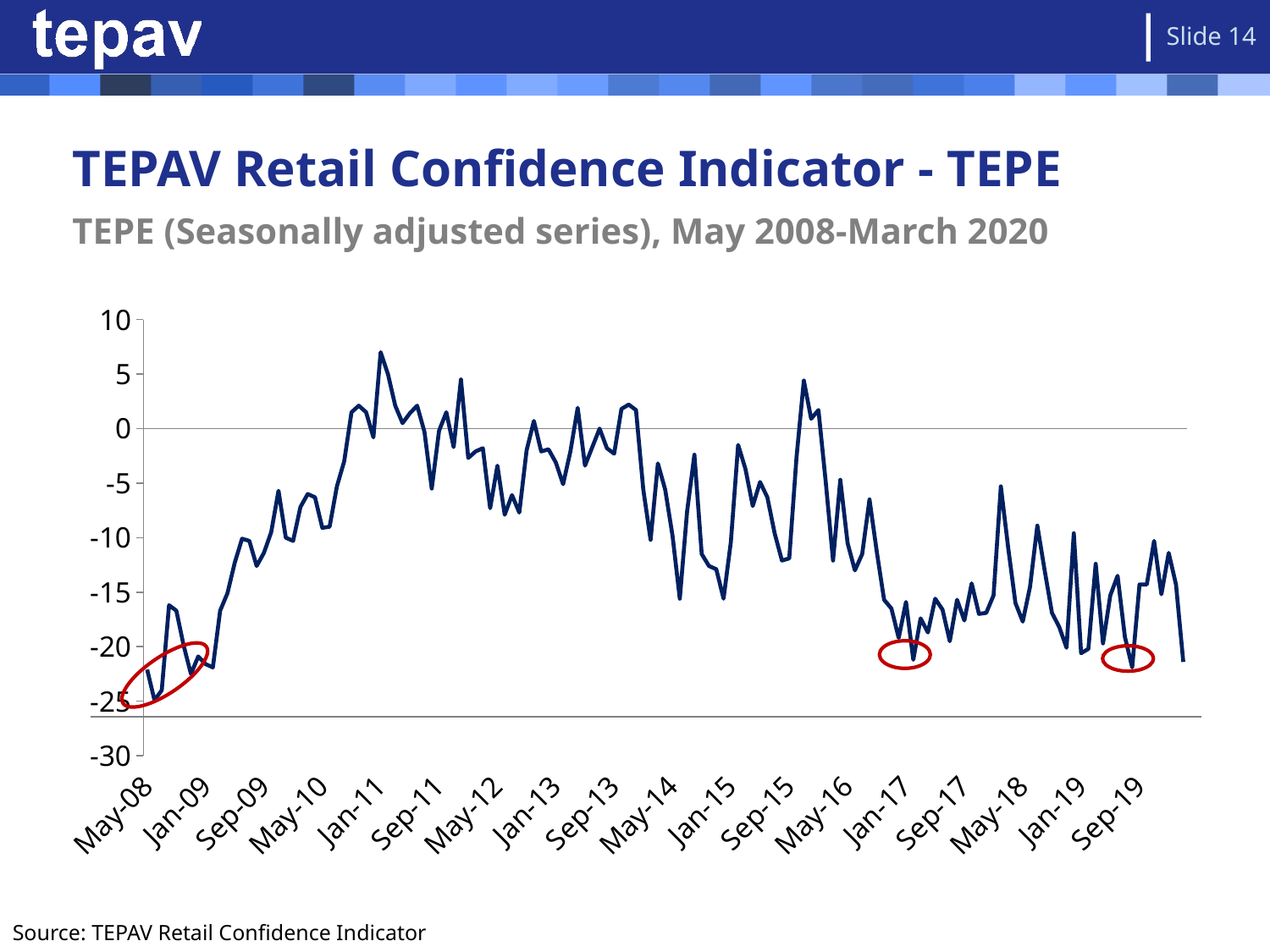
What is the title of the chart on the slide? TEPAV Retail Confidence Indicator - TEPE What kind of chart is shown on the slide? Line chart How many date labels are shown along the x axis? 18 Around which x-axis label does the line reach its lowest point? May-08 Is the value at May-08 greater or less than -20? less Around which x-axis label does the line reach its highest point? Jan-11 Is the peak value near Jan-11 greater or less than 5? greater Does the line generally rise or fall between May-08 and Jan-11? rise What period does the chart subtitle say the series covers? May 2008-March 2020 How many data series are plotted on the chart? 1 Does the line generally rise or fall between Jan-11 and the end of the series? fall